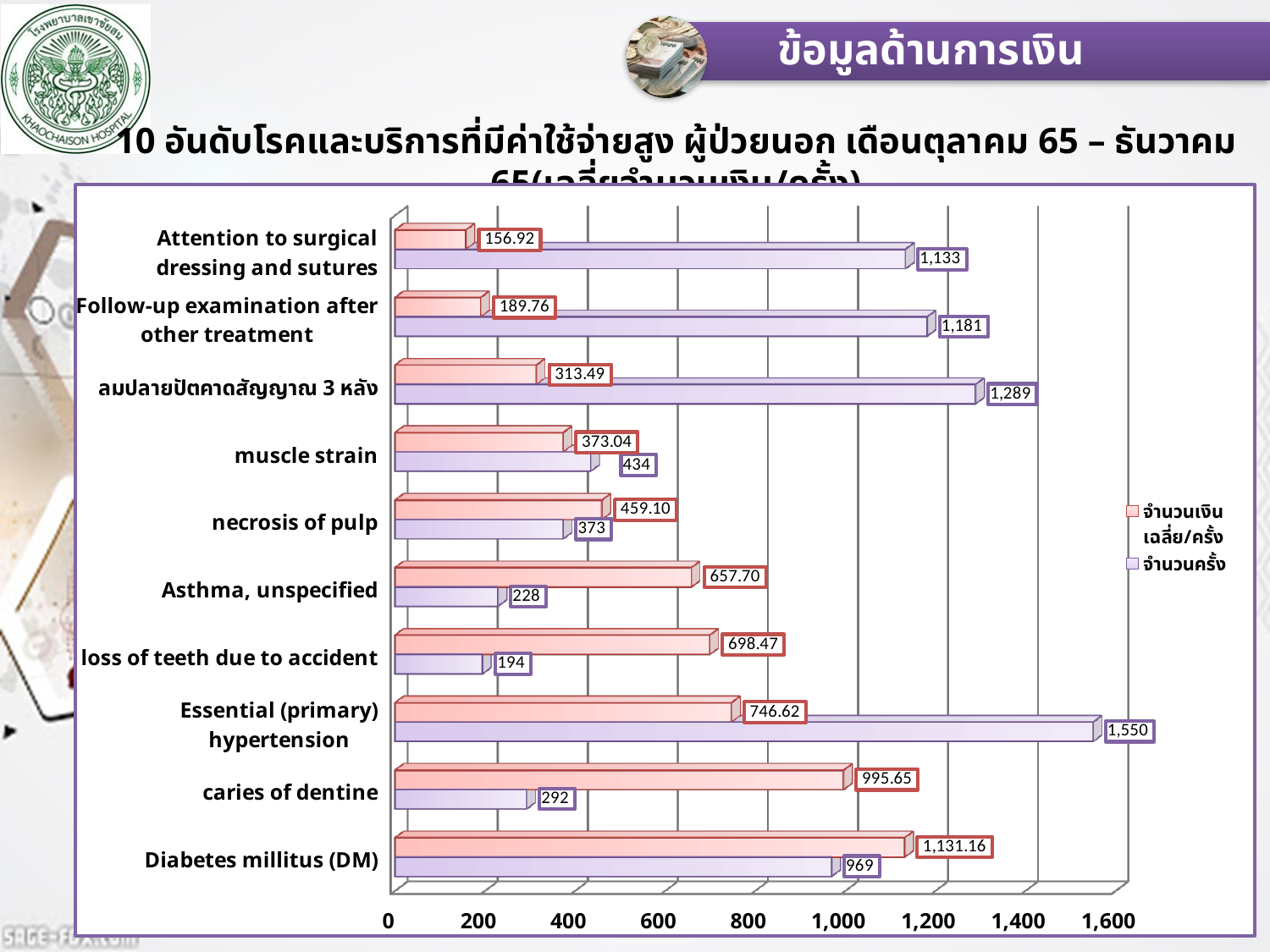
What is the จำนวนครั้ง value for Asthma, unspecified? 228 What is the จำนวนครั้ง value for Essential (primary) hypertension? 1,550 Which is larger: the จำนวนครั้ง value for muscle strain or for necrosis of pulp? muscle strain Which category has the lowest จำนวนครั้ง value? loss of teeth due to accident Which category has the lowest จำนวนเงินเฉลี่ย/ครั้ง value? Attention to surgical dressing and sutures How many series does the legend list? 2 What is the จำนวนเงินเฉลี่ย/ครั้ง value for Diabetes millitus (DM)? 1,131.16 What is the จำนวนเงินเฉลี่ย/ครั้ง value for caries of dentine? 995.65 What kind of chart is shown on the slide? Bar chart How many categories are shown on the chart? 10 Which category has the highest จำนวนครั้ง value? Essential (primary) hypertension What is the difference between the จำนวนครั้ง values for Essential (primary) hypertension and Diabetes millitus (DM)? 581